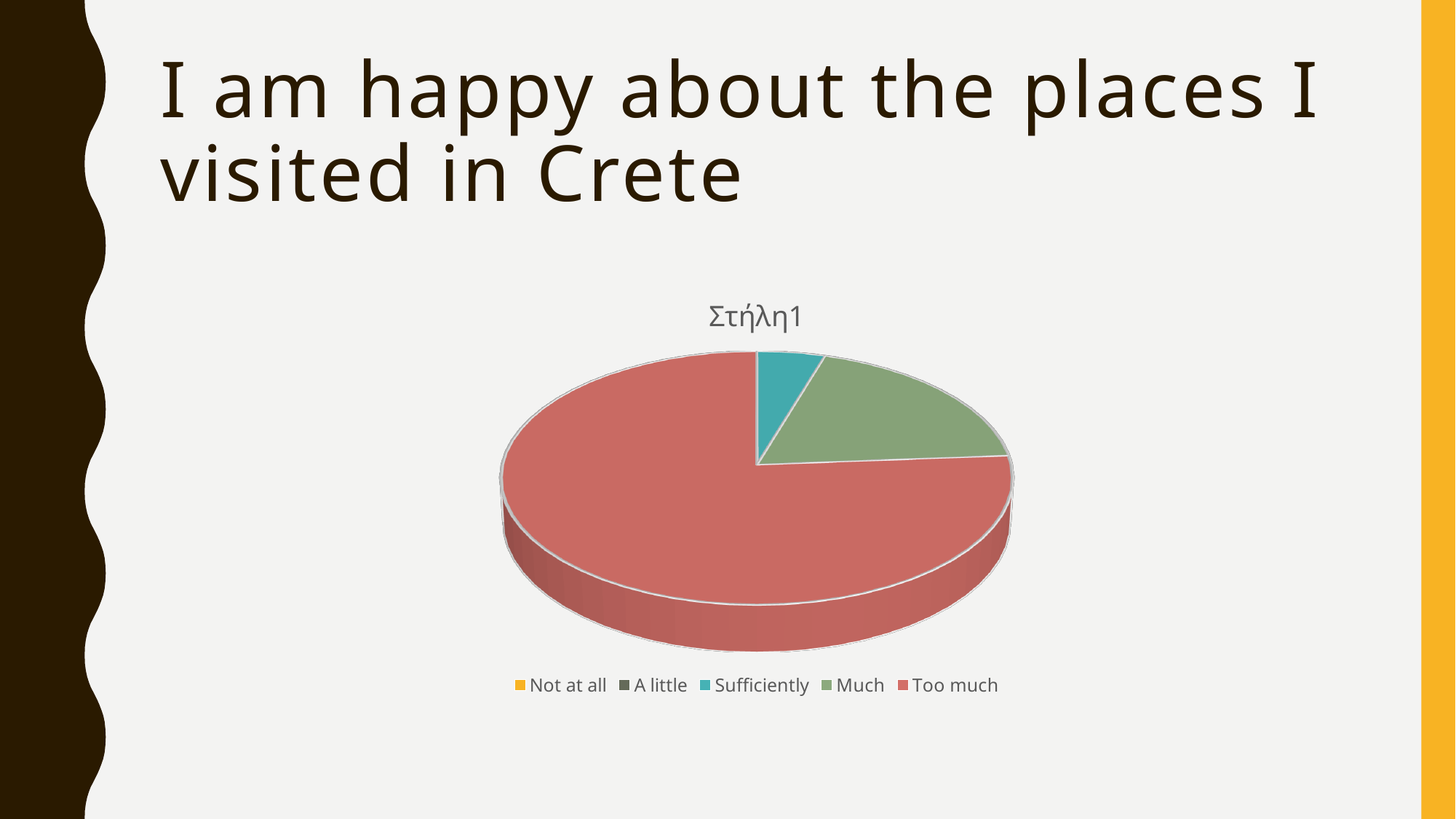
Is the share of the pie for Too much greater or less than 50%? greater What is the title shown above the pie chart? Στήλη1 How many categories does the legend list? 5 Is the share of the pie for Much greater or less than 50%? less Which slice is larger, Much or Sufficiently? Much What kind of chart is shown on the slide? Pie chart Which category has the largest slice of the pie? Too much Of the slices visible in the pie, which category has the smallest? Sufficiently How many slices are visible in the pie? 3 Which slice is larger, Too much or Much? Too much What colour is the slice for Too much? Red